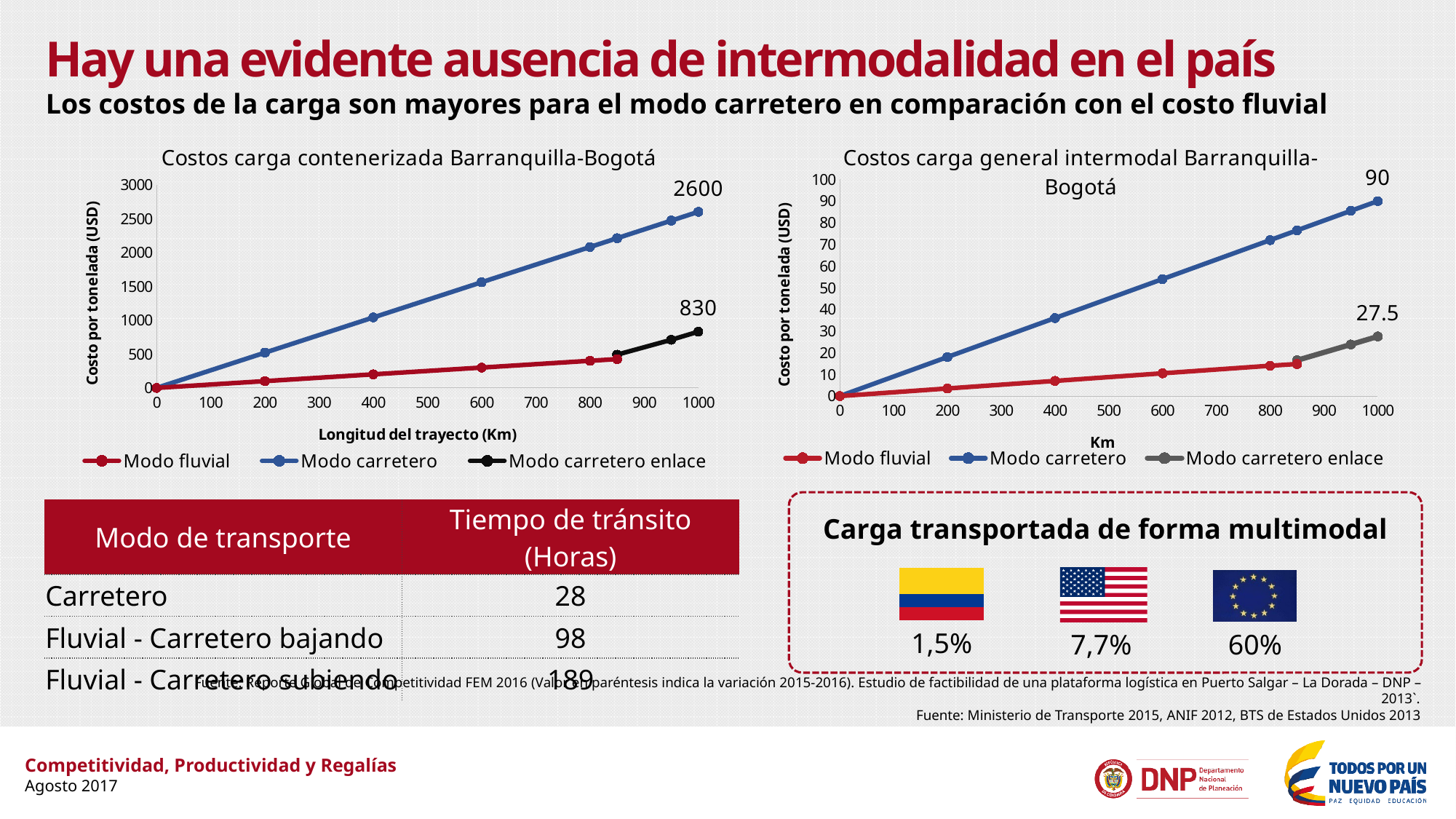
In the chart 'Costos carga contenerizada Barranquilla-Bogotá', what is the labelled value for Modo carretero at 1000 km? 2600 In the chart 'Costos carga general intermodal Barranquilla-Bogotá', is the value for Modo carretero at 600 km greater or less than 50? greater In the chart 'Costos carga contenerizada Barranquilla-Bogotá', is the value for Modo fluvial at 800 km greater or less than 500? less In the chart 'Costos carga general intermodal Barranquilla-Bogotá', what is the labelled value for Modo carretero enlace at 1000 km? 27.5 How many series does the legend of the chart 'Costos carga general intermodal Barranquilla-Bogotá' list? 3 In the chart 'Costos carga contenerizada Barranquilla-Bogotá', which series has the highest cost at 1000 km? Modo carretero In the chart 'Costos carga contenerizada Barranquilla-Bogotá', what is the difference between the labelled values 2600 and 830? 1770 What kind of chart is 'Costos carga contenerizada Barranquilla-Bogotá'? Line chart In the chart 'Costos carga general intermodal Barranquilla-Bogotá', what is the labelled value for Modo carretero at 1000 km? 90 In the chart 'Costos carga contenerizada Barranquilla-Bogotá', what is the labelled value for Modo carretero enlace at 1000 km? 830 In the chart 'Costos carga general intermodal Barranquilla-Bogotá', does the Modo carretero line rise or fall as the distance in km increases? Rises In the chart 'Costos carga general intermodal Barranquilla-Bogotá', what is the difference between the labelled values 90 and 27.5? 62.5